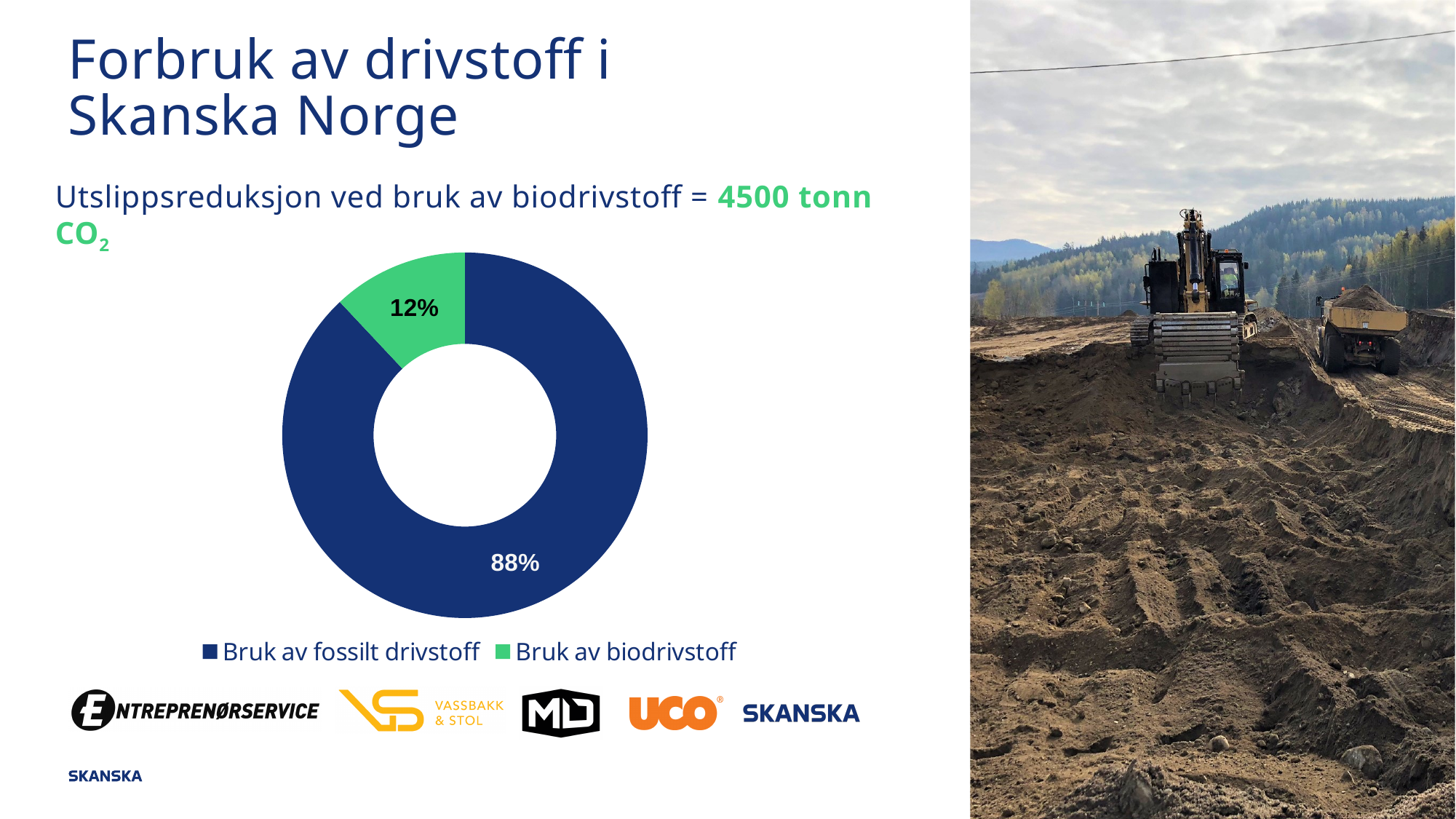
What colour represents 'Bruk av biodrivstoff' in the chart? Green Which category has the smallest share of the chart? Bruk av biodrivstoff What is the difference in percentage points between 'Bruk av fossilt drivstoff' and 'Bruk av biodrivstoff'? 76 percentage points Is the share for 'Bruk av biodrivstoff' greater or less than 50%? less How many entries does the legend list? 2 Which category has the largest share of the chart? Bruk av fossilt drivstoff What share of fuel consumption is 'Bruk av fossilt drivstoff'? 88% What share of fuel consumption is 'Bruk av biodrivstoff'? 12% Which is larger: the share for 'Bruk av fossilt drivstoff' or 'Bruk av biodrivstoff'? Bruk av fossilt drivstoff What colour represents 'Bruk av fossilt drivstoff' in the chart? Dark blue How many categories does the chart show? 2 What kind of chart is shown on the slide? Doughnut (pie) chart